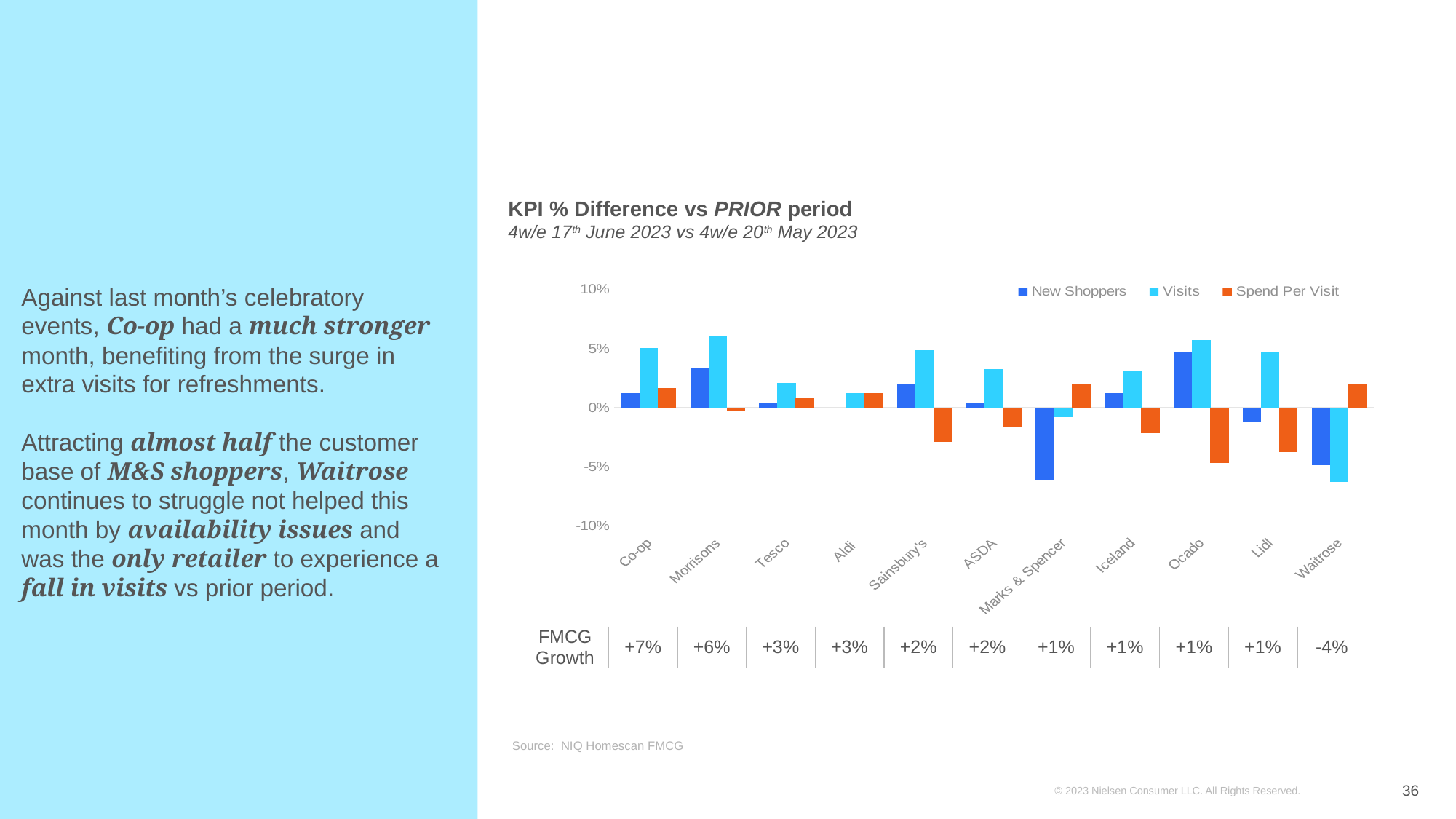
What is the FMCG Growth value shown for Co-op? +7% What is the FMCG Growth value shown for Morrisons? +6% Which retailer has the lowest FMCG Growth value? Waitrose Is the Visits value for Morrisons greater or less than 5%? greater Which retailer has the lowest Visits value in the chart? Waitrose How many retailers are shown on the x axis of the chart? 11 How many series does the legend list? 3 Is the New Shoppers value for Marks & Spencer greater or less than -5%? less What is the difference in FMCG Growth between Co-op and Waitrose? 11 percentage points What kind of chart is shown on the slide? Bar chart Which retailer has the lowest New Shoppers value in the chart? Marks & Spencer What is the FMCG Growth value shown for Waitrose? -4%